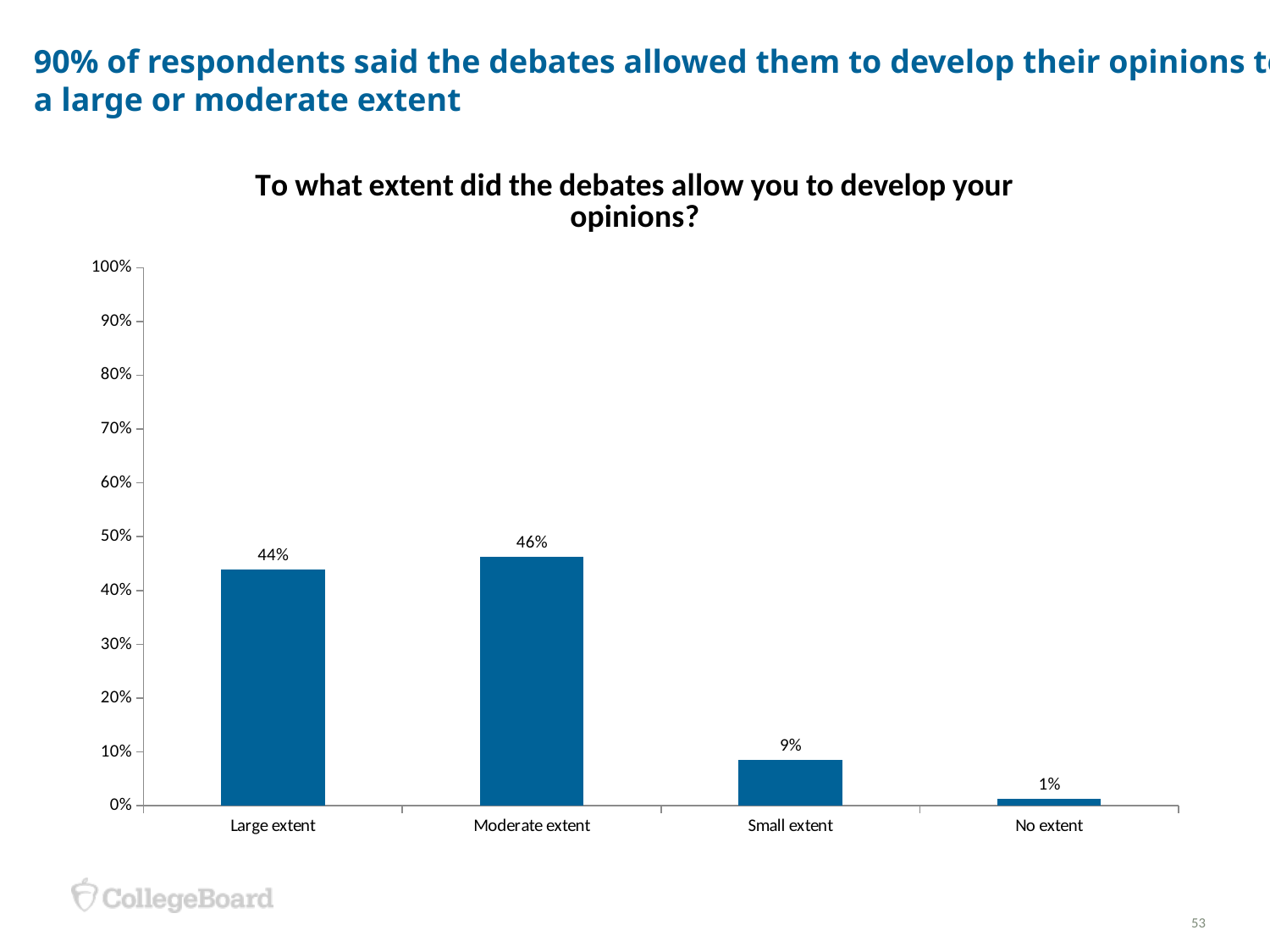
How many categories are shown on the x axis? 4 Which category has the highest value? Moderate extent What kind of chart is shown on the slide? Bar chart Which category has the lowest value? No extent What is the title of the chart? To what extent did the debates allow you to develop your opinions? What is the difference between the values for Small extent and No extent? 8% What percentage of respondents said the debates allowed them to develop their opinions to a large extent? 44% Which is larger, the value for Large extent or the value for Small extent? Large extent What is the value shown for Moderate extent? 46% What is the difference between the values for Moderate extent and Large extent? 2% What is the value shown for Small extent? 9% What is the value shown for No extent? 1%